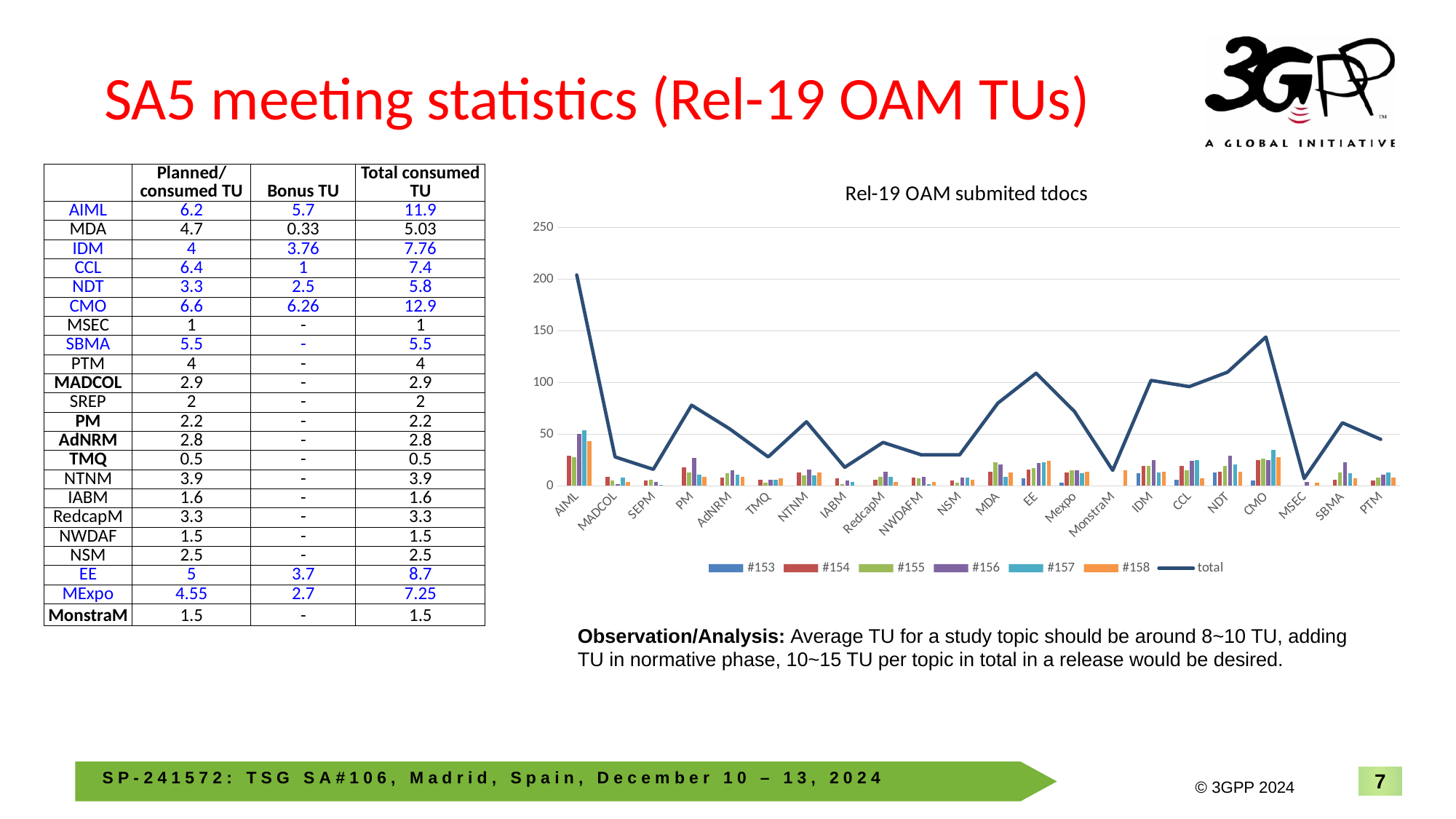
Which has the larger 'total' value, AIML or CMO? AIML Which category has the highest value on the 'total' line? AIML What kind of chart is shown on the slide? Combined bar and line chart How many series does the chart legend list? 7 Which category has the lowest value on the 'total' line? MSEC What is the title of the chart on the slide? Rel-19 OAM submited tdocs Is the 'total' value for CMO greater or less than 100? greater Which has the larger 'total' value, CMO or MDA? CMO How many categories are shown along the x axis of the chart? 22 Is the 'total' value for AIML greater or less than 150? greater Does the 'total' line rise or fall from MonstraM to CMO? rise Is the 'total' value for MADCOL greater or less than 50? less